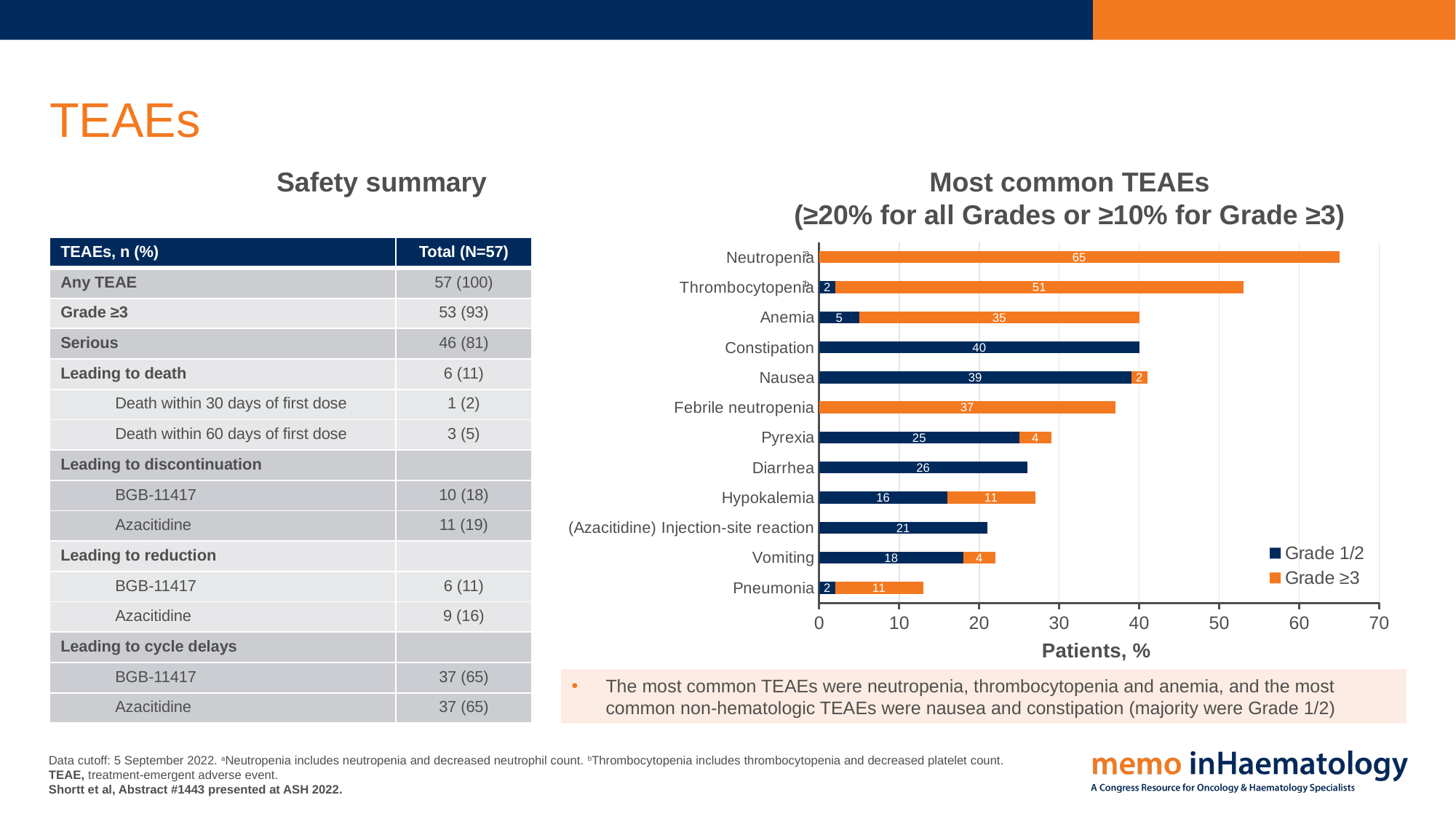
What type of chart is shown on the slide? Stacked bar chart What is the label of the x axis? Patients, % What is the difference between the Grade ≥3 values for Neutropenia and Thrombocytopenia? 14 Which TEAE has the highest Grade ≥3 value? Neutropenia What is the Grade 1/2 value for Constipation? 40 How many TEAE categories are plotted in the chart? 12 What is the Grade ≥3 value for Hypokalemia? 11 What is the total (Grade 1/2 plus Grade ≥3) for Thrombocytopenia? 53 What is the Grade ≥3 value for Neutropenia? 65 Which is larger, the Grade 1/2 value for Diarrhea or the Grade 1/2 value for Vomiting? Diarrhea How many series does the chart legend list? 2 What is the total (Grade 1/2 plus Grade ≥3) for Pneumonia? 13